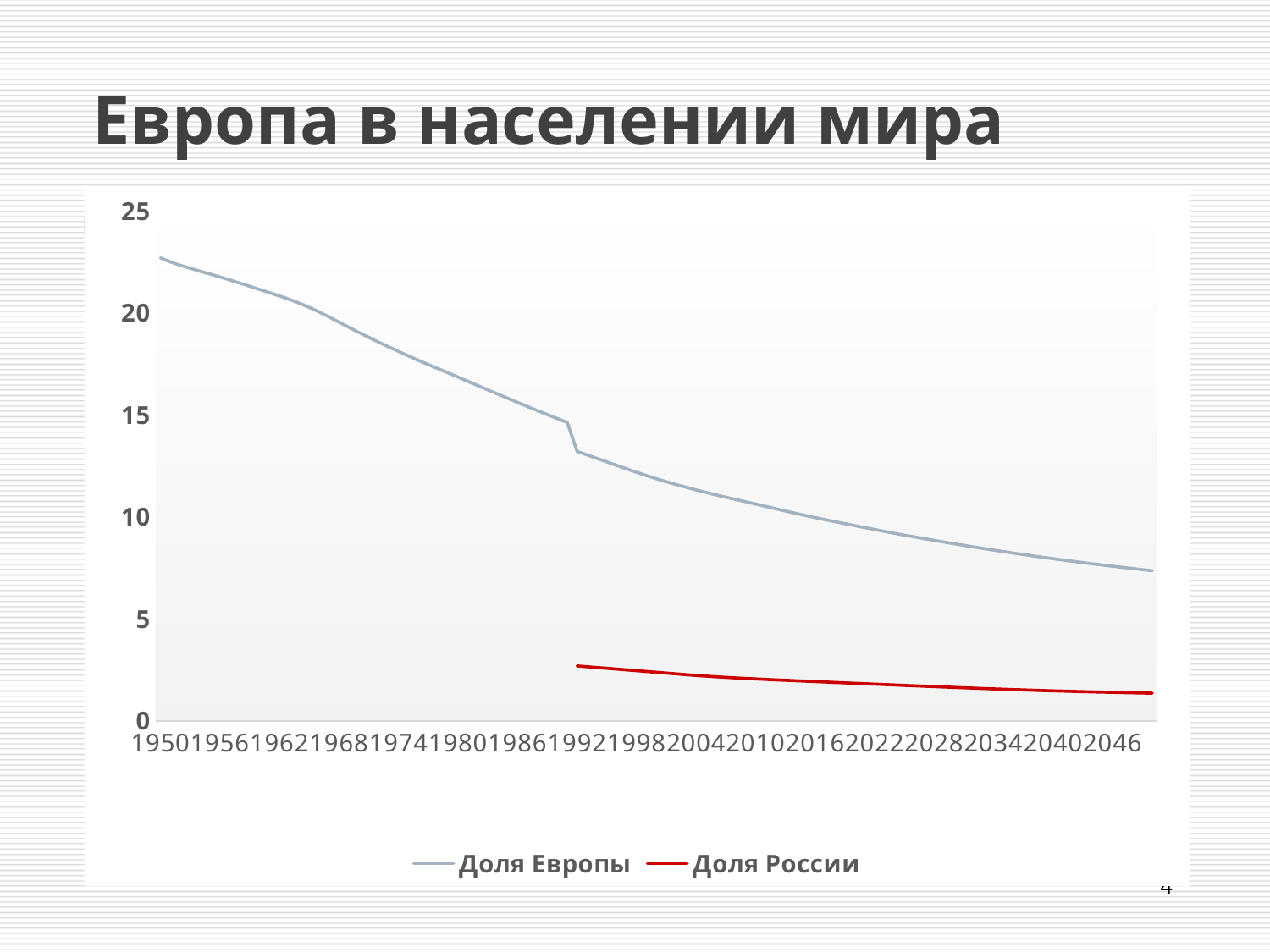
In 2046, which series has the larger value, Доля Европы or Доля России? Доля Европы Does the Доля Европы line rise or fall from 1950 to 2046? fall Is the value for Доля Европы in 1980 greater or less than 15? greater What kind of chart is shown on the slide? line chart Is the value for Доля Европы in 1950 greater or less than 20? greater Which colour is used for the Доля России line? red What is the title of the chart? Европа в населении мира How many series does the legend list? 2 Is the value for Доля Европы in 2046 greater or less than 10? less Does the Доля России line rise or fall over the years shown? fall